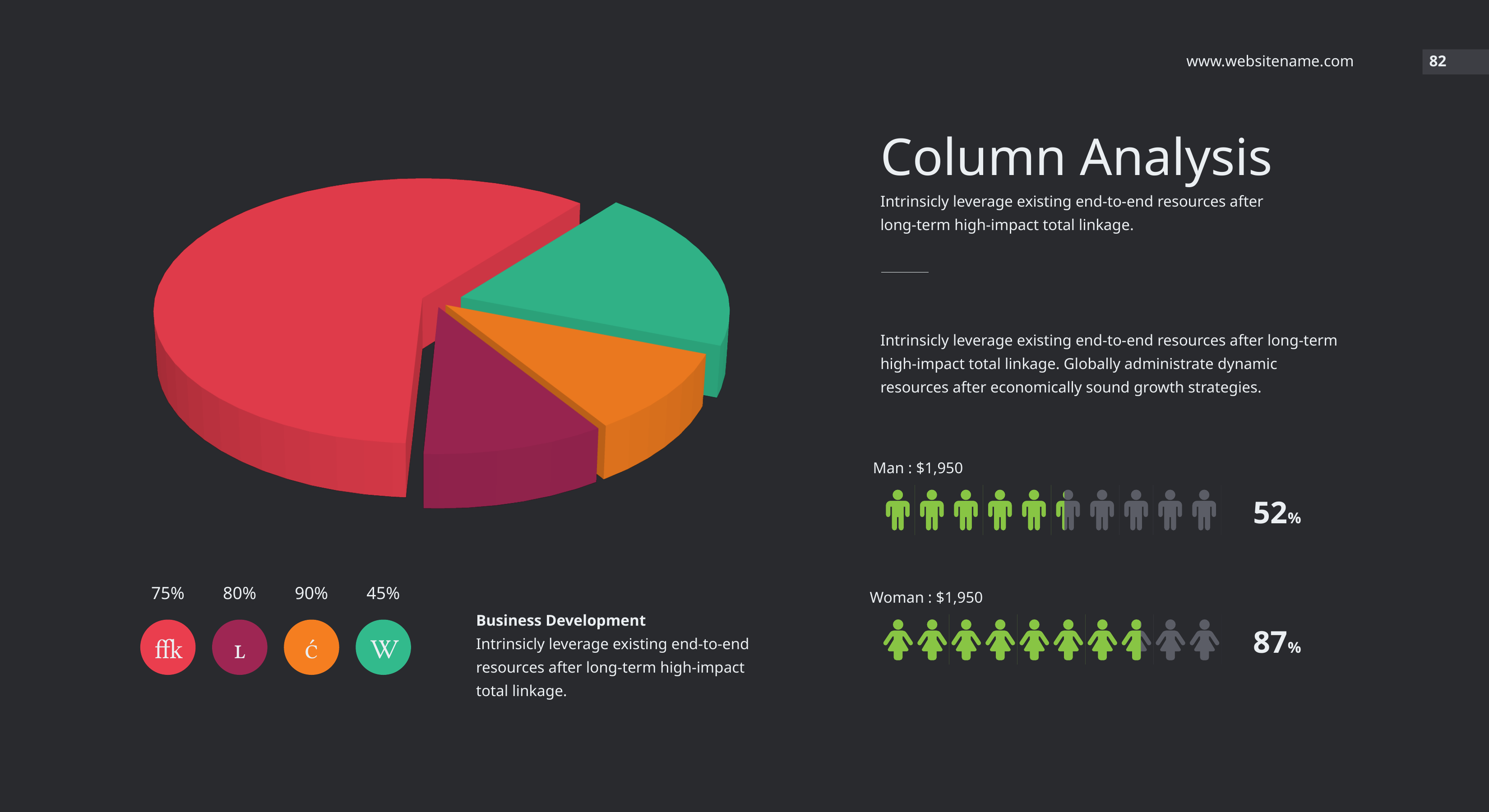
In the pictograph on the right, what percentage is shown for Woman? 87% In the pictograph on the right, which has the higher percentage, Man or Woman? Woman In the pictograph on the right, what is the difference between the Woman percentage and the Man percentage? 35% In the pictograph on the right, what dollar amount is shown next to Woman? $1,950 What kind of chart is shown on the left of the slide? pie chart In the pictograph on the right, what percentage is shown for Man? 52% Which colour slice is the largest in the pie chart on the left? red What is the title of the slide containing the pie chart? Column Analysis What colour are the filled person icons in the pictograph on the right? green In the pictograph on the right, what dollar amount is shown next to Man? $1,950 In the pictograph on the right, how many person icons are shown in the Man row? 10 How many slices does the pie chart on the left have? 4